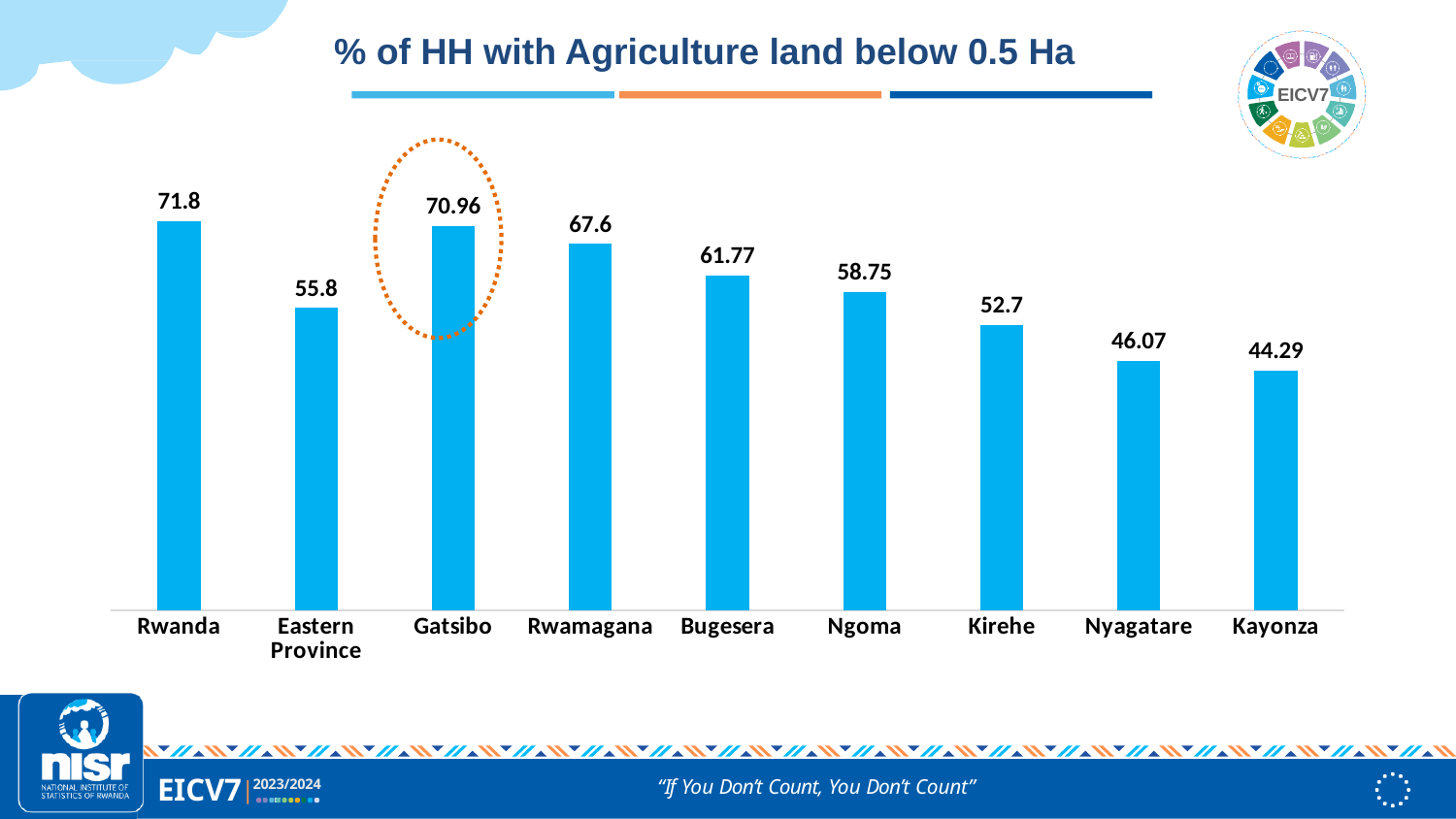
Do the values rise or fall from Gatsibo to Kayonza along the x axis? Fall What is the value for Kayonza? 44.29 What is the value for Eastern Province? 55.8 Which category has the lowest value? Kayonza Which category has the highest value? Rwanda What is the difference between the values for Gatsibo and Kayonza? 26.67 What is the title of the chart? % of HH with Agriculture land below 0.5 Ha What kind of chart is this? Bar chart How many categories are shown on the x axis? 9 What is the value for Gatsibo? 70.96 Which is larger, the value for Bugesera or the value for Ngoma? Bugesera What is the difference between the values for Rwanda and Eastern Province? 16